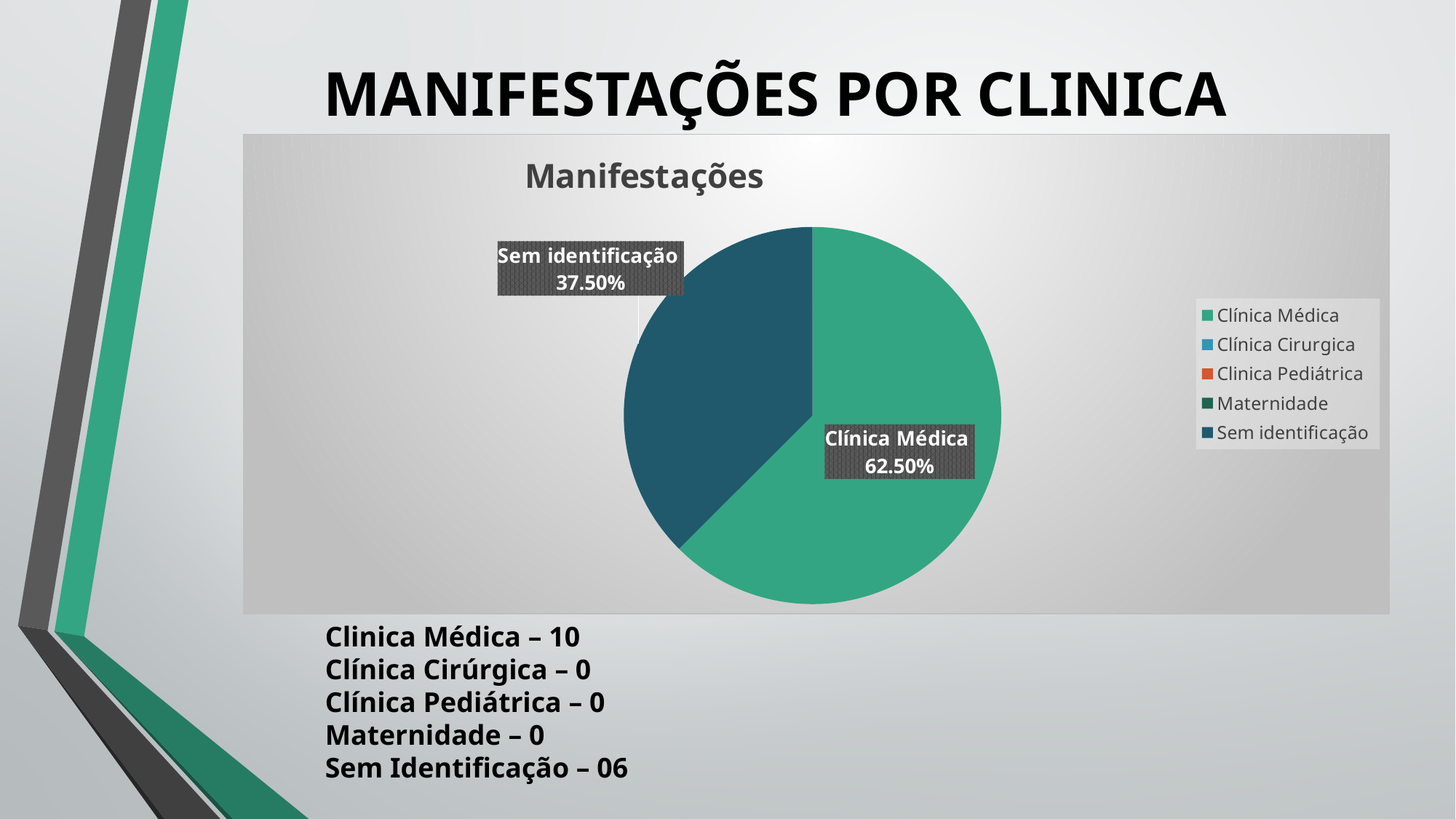
How many entries does the legend list? 5 What share of the pie does Sem identificação represent? 37.50% Which slice is larger, Clínica Médica or Sem identificação? Clínica Médica What is the title of the chart? Manifestações What kind of chart is shown on the slide? pie chart What is the difference in percentage points between the Clínica Médica and Sem identificação slices? 25.00% Which category has the largest slice of the pie? Clínica Médica How many slices are visible in the pie? 2 Is the share for Clínica Médica greater or less than 50%? greater Which legend entry is shown in the dark blue colour used for the smaller slice? Sem identificação What share of the pie does Clínica Médica represent? 62.50%